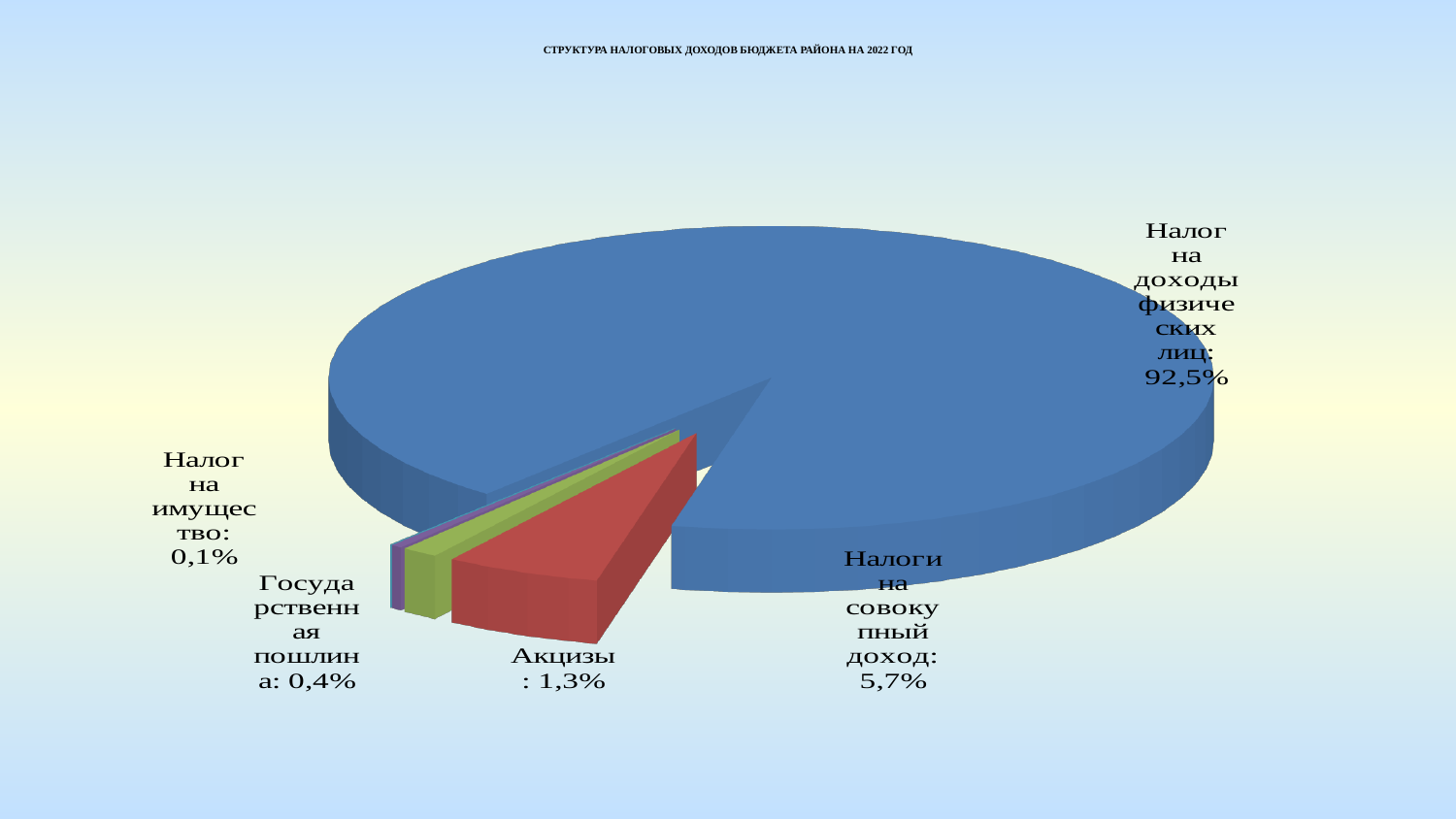
What is the value shown for Налоги на совокупный доход? 5,7% Which is larger, the share for Акцизы or the share for Государственная пошлина? Акцизы What is the title of the chart? СТРУКТУРА НАЛОГОВЫХ ДОХОДОВ БЮДЖЕТА РАЙОНА НА 2022 ГОД How many slices does the pie chart have? 5 What share of the pie is Налог на доходы физических лиц? 92,5% What is the value shown for Акцизы? 1,3% Which category has the largest share of the pie? Налог на доходы физических лиц What type of chart is shown on the slide? Pie chart What is the value shown for Государственная пошлина? 0,4% Which category has the smallest share of the pie? Налог на имущество What is the difference between the shares of Налоги на совокупный доход and Акцизы? 4,4% What is the value shown for Налог на имущество? 0,1%